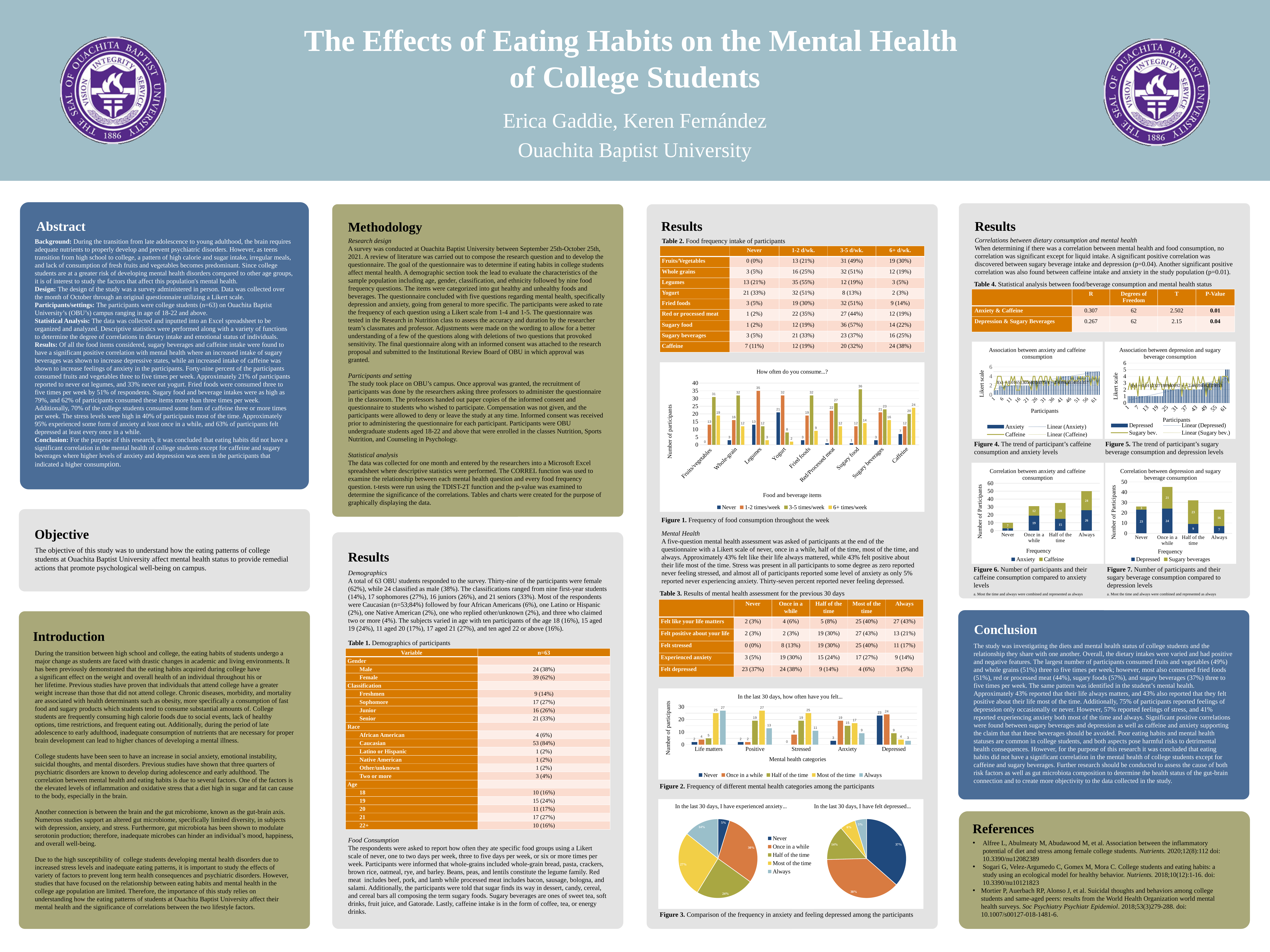
In the 'How often do you consume...?' chart (Figure 1), what is the difference between the 6+ times/week value for caffeine and the 6+ times/week value for sugary beverages? 8 In the 'How often do you consume...?' chart (Figure 1), how many participants reported consuming legumes 1-2 times/week? 35 In the 'In the last 30 days, how often have you felt...' chart (Figure 2), how many participants answered 'Never' for Depressed? 23 In the pie chart 'In the last 30 days, I have experienced anxiety...' (Figure 3), what share of participants answered 'Once in a while'? 30% In the 'How often do you consume...?' chart (Figure 1), how many food and beverage categories are shown on the x axis? 9 In the 'In the last 30 days, how often have you felt...' chart (Figure 2), which is larger: the 'Most of the time' value for Positive or the 'Most of the time' value for Anxiety? Positive In the 'How often do you consume...?' chart (Figure 1), how many participants reported never consuming yogurt? 21 In the 'How often do you consume...?' chart (Figure 1), how many series does the legend list? 4 In the 'In the last 30 days, how often have you felt...' chart (Figure 2), how many series does the legend list? 5 What kind of chart is Figure 4, 'Association between anxiety and caffeine consumption'? Combination bar and line chart In the 'How often do you consume...?' chart (Figure 1), which food item has the highest number of participants in the 3-5 times/week series? Sugary food In the pie chart 'In the last 30 days, I have felt depressed...' (Figure 3), what share of participants answered 'Never'? 37%